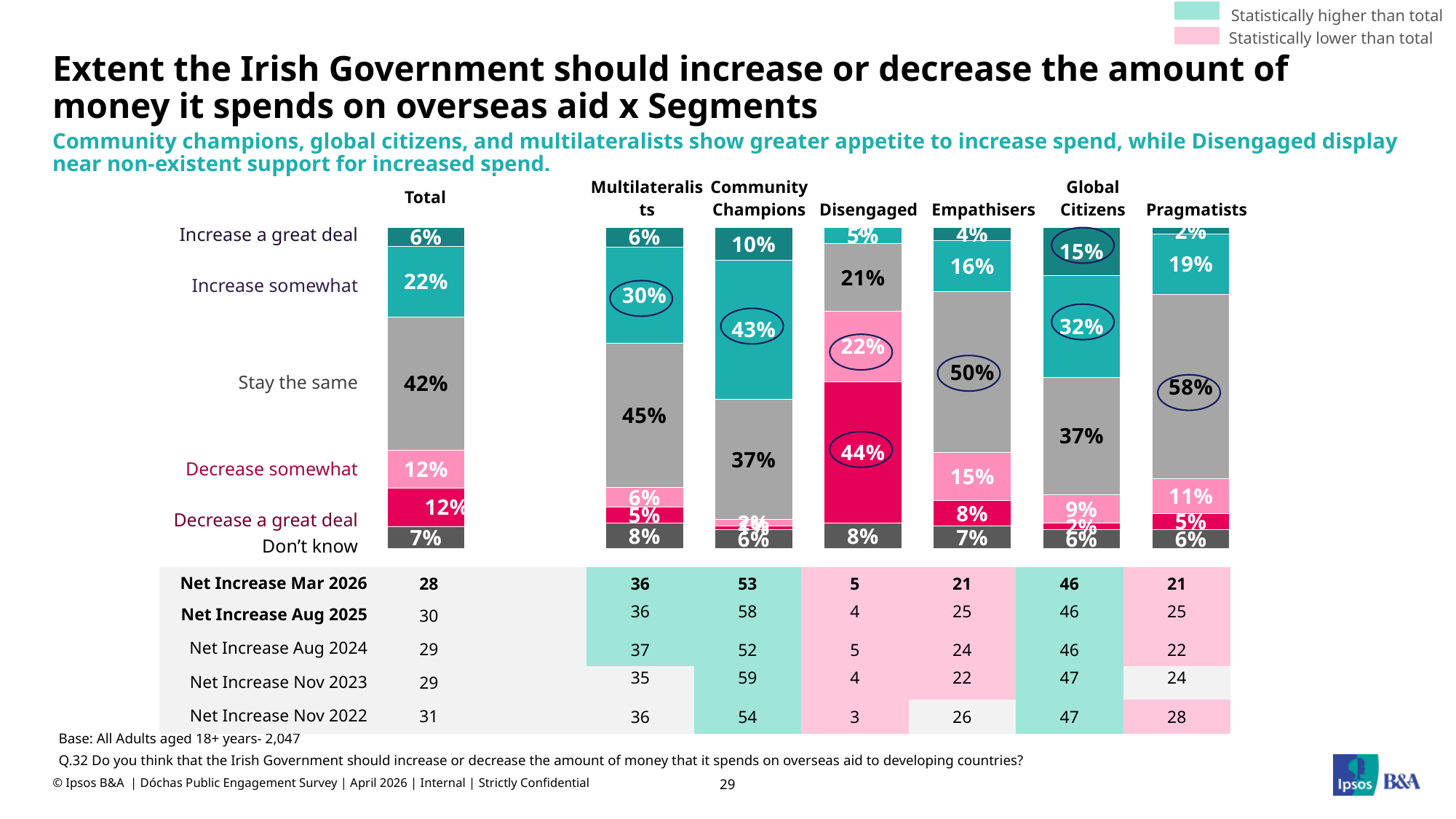
How many stacked bars (groups) are shown in the chart, including Total? 7 What type of chart is used on this slide? Stacked bar chart What percentage of Pragmatists say the amount spent on overseas aid should stay the same? 58% What percentage of the Disengaged segment say spending should decrease a great deal? 44% What is the Net Increase Mar 2026 value for Community Champions? 53 Which has a larger 'Increase somewhat' share: Multilateralists or Global Citizens? Global Citizens Which segment has the highest 'Stay the same' percentage? Pragmatists What percentage of Community Champions say spending should increase somewhat? 43% How many percentage points higher is the 'Stay the same' share for Empathisers than for Total? 8 percentage points According to the legend, what does the light green shading indicate? Statistically higher than total Which segment has the lowest Net Increase for Mar 2026? Disengaged What percentage of Multilateralists answered 'Don't know'? 8%